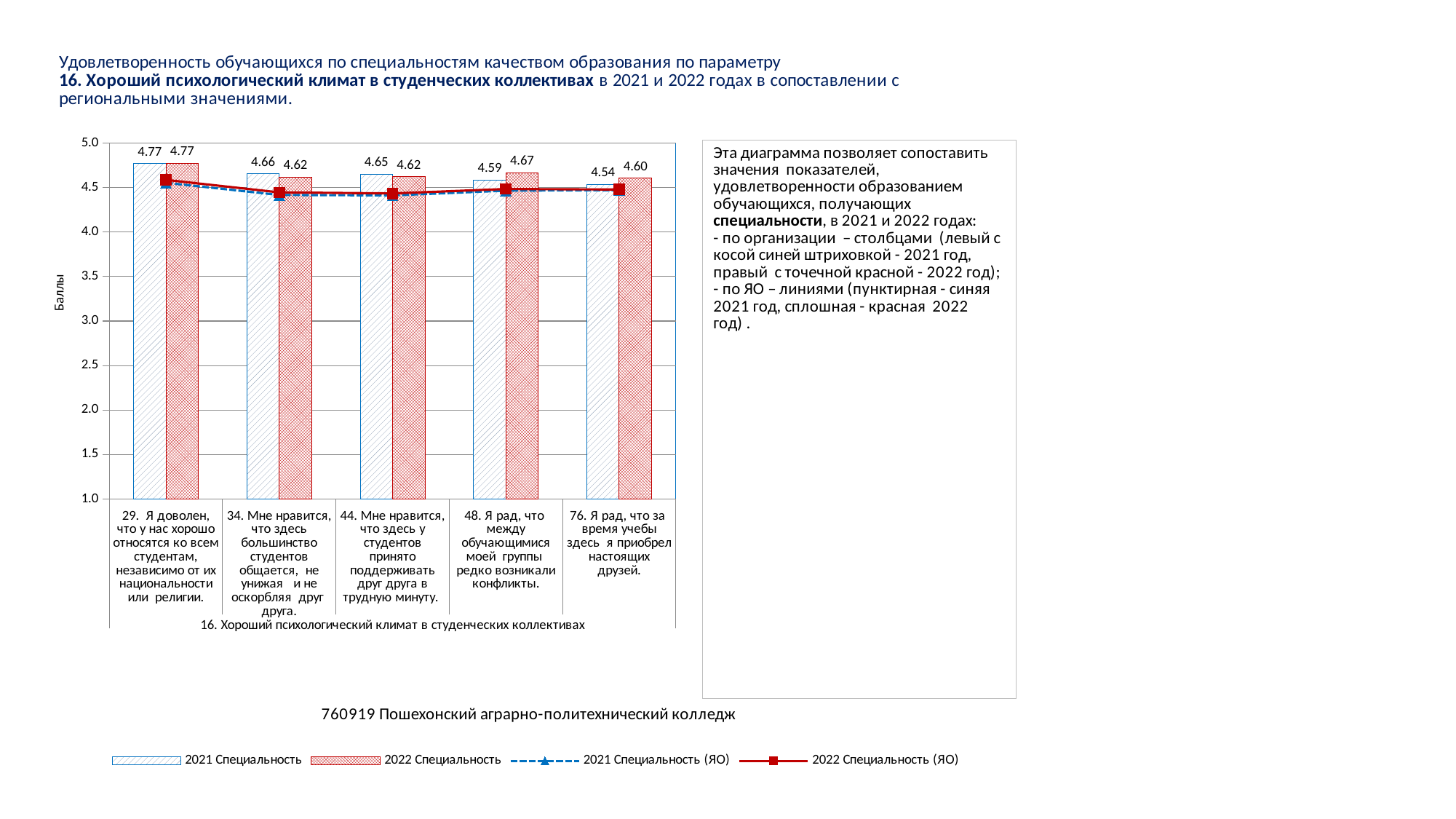
What is the label of the vertical axis? Баллы What is the value of the 2021 Специальность bar for category 76 (Я рад, что за время учебы здесь я приобрел настоящих друзей)? 4.54 What is the value of the 2022 Специальность bar for category 48 (Я рад, что между обучающимися моей группы редко возникали конфликты)? 4.67 What is the value of the 2021 Специальность bar for category 29 (Я доволен, что у нас хорошо относятся ко всем студентам...)? 4.77 Which category has the highest 2022 Специальность bar? 29. Я доволен, что у нас хорошо относятся ко всем студентам, независимо от их национальности или религии. Is the 2022 Специальность (ЯО) line value for category 29 greater or less than 4.0? greater For category 34, which is larger: the 2021 Специальность bar or the 2022 Специальность bar? 2021 Специальность Which category has the lowest 2021 Специальность bar? 76. Я рад, что за время учебы здесь я приобрел настоящих друзей. How many series does the legend list? 4 What kind of chart is shown on the slide? Combined bar and line chart What is the difference between the 2022 and 2021 Специальность bars for category 48? 0.08 How many categories are shown on the x axis? 5